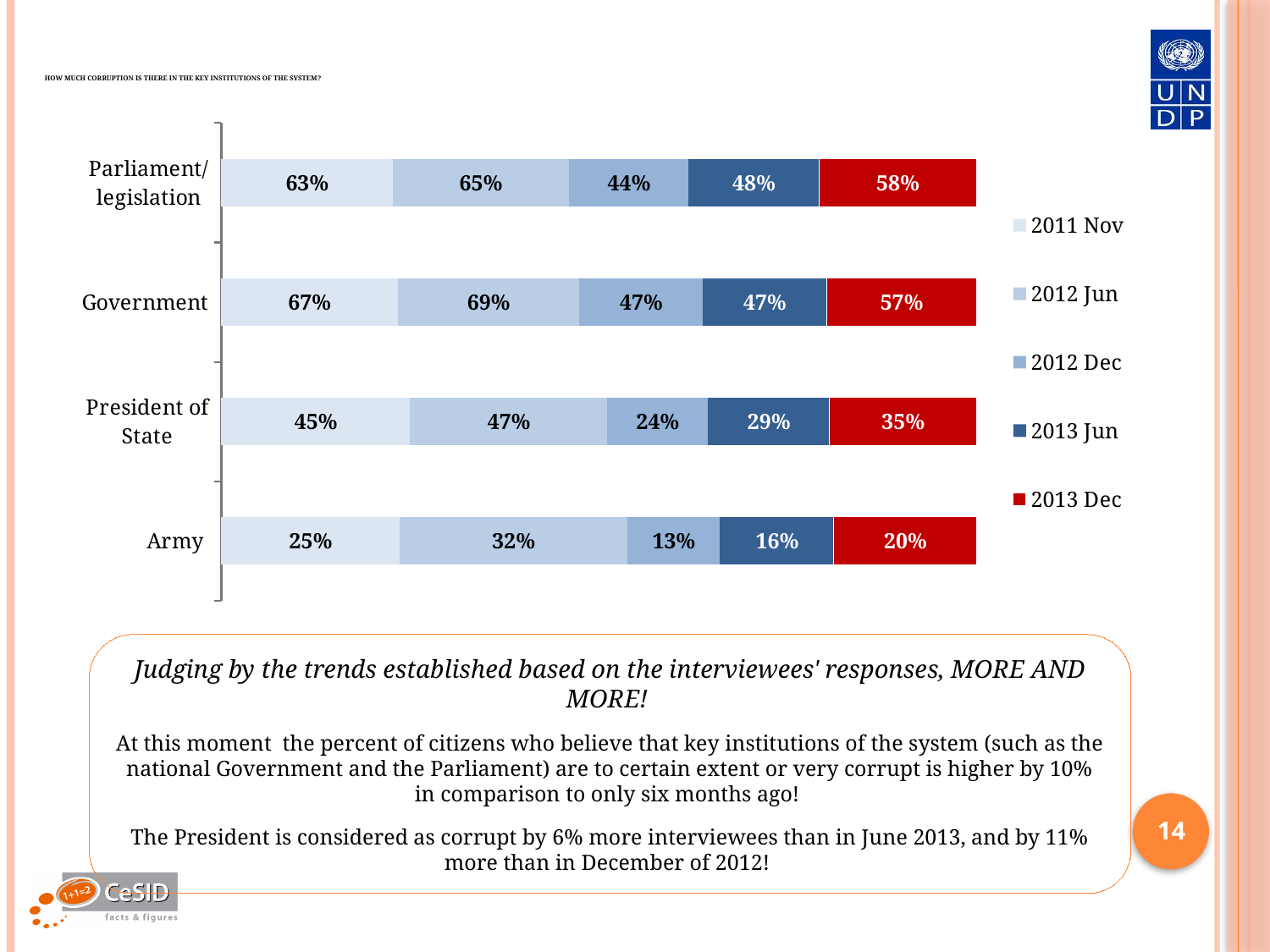
What is the value for Government in 2013 Dec? 57% What is the value for President of State in 2012 Dec? 24% Which is larger for Government: the 2011 Nov value or the 2012 Jun value? 2012 Jun What is the value for Parliament/legislation in 2012 Jun? 65% Which institution has the lowest value in 2012 Jun? Army Which institution has the highest value in 2013 Dec? Parliament/legislation What is the difference between the 2013 Dec and 2013 Jun values for President of State? 6% How many institutions are shown on the chart? 4 Which series is shown in red in the legend? 2013 Dec What is the value for Army in 2011 Nov? 25% What kind of chart is shown on the slide? Stacked bar chart How many series does the legend list? 5